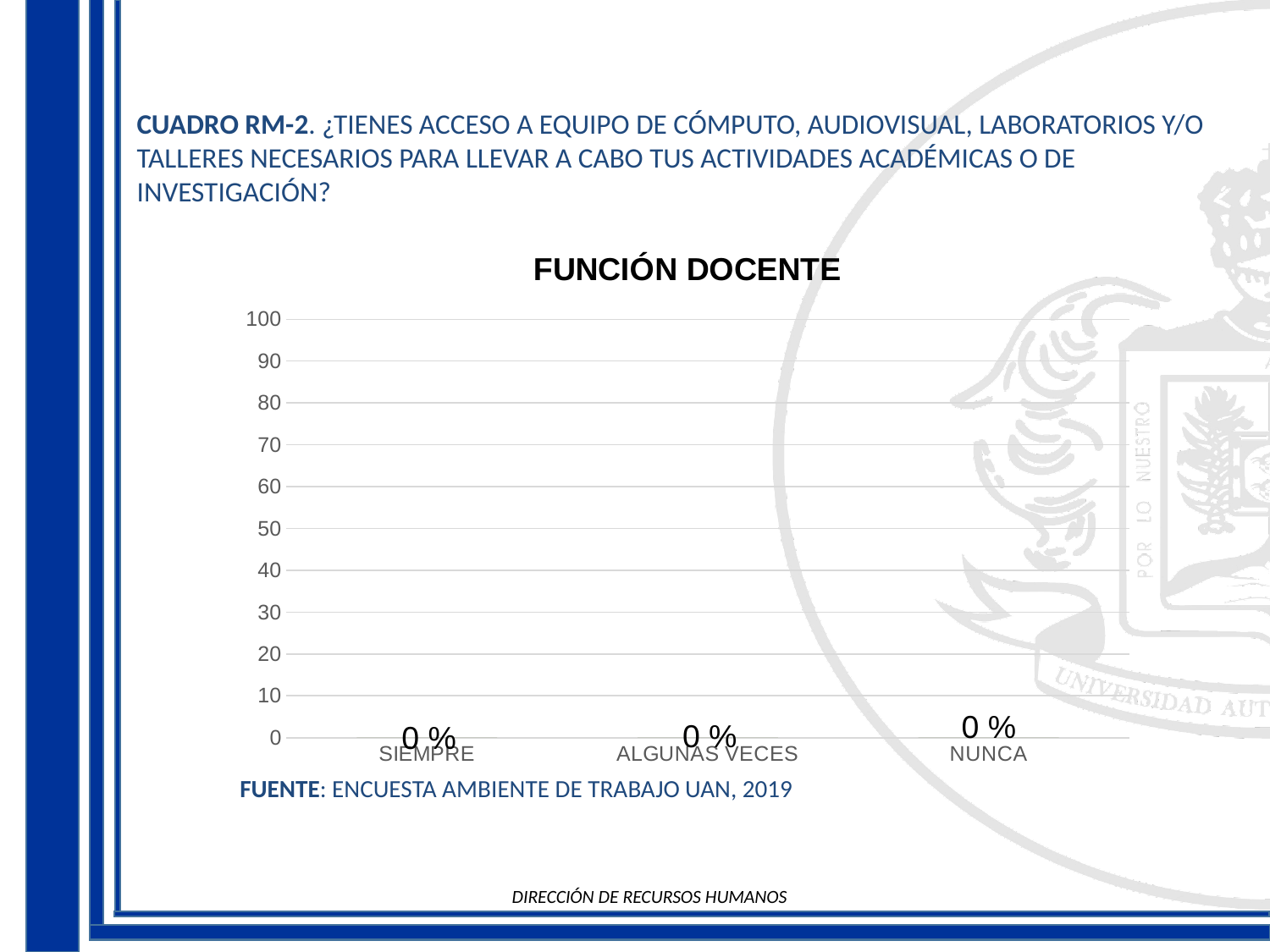
How many categories are shown on the x axis? 3 What is the value for NUNCA? 0 % What is the value for ALGUNAS VECES? 0 % Is the value for NUNCA greater or less than 50? less What is the highest value shown on the y axis? 100 What is the value for SIEMPRE? 0 % What is the title of the chart? FUNCIÓN DOCENTE Is the value for ALGUNAS VECES greater or less than 10? less What is the difference between the values for SIEMPRE and NUNCA? 0 %